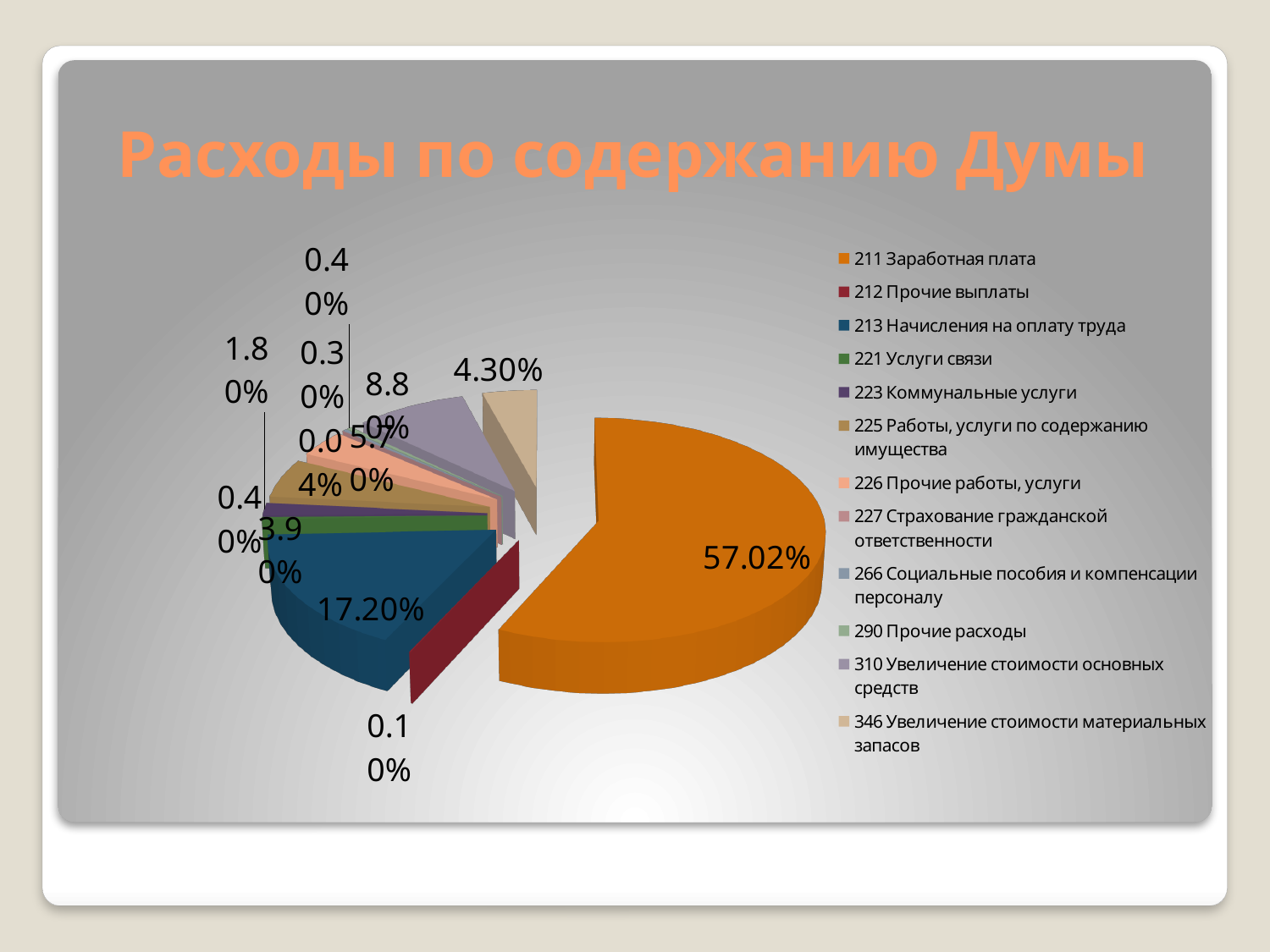
What is the value shown for 213 Начисления на оплату труда? 17.20% What is the difference between the shares of 211 Заработная плата and 213 Начисления на оплату труда? 39.82% What is the title of the chart? Расходы по содержанию Думы What share of the pie does 211 Заработная плата take? 57.02% How many categories does the legend list? 12 Which category has the largest slice of the pie? 211 Заработная плата What colour is the slice for 211 Заработная плата? orange Which is larger: the slice for 213 Начисления на оплату труда or the slice for 346 Увеличение стоимости материальных запасов? 213 Начисления на оплату труда What kind of chart is shown on the slide? pie chart What is the value shown for 346 Увеличение стоимости материальных запасов? 4.30% Which is larger: the slice for 211 Заработная плата or the slice for 213 Начисления на оплату труда? 211 Заработная плата